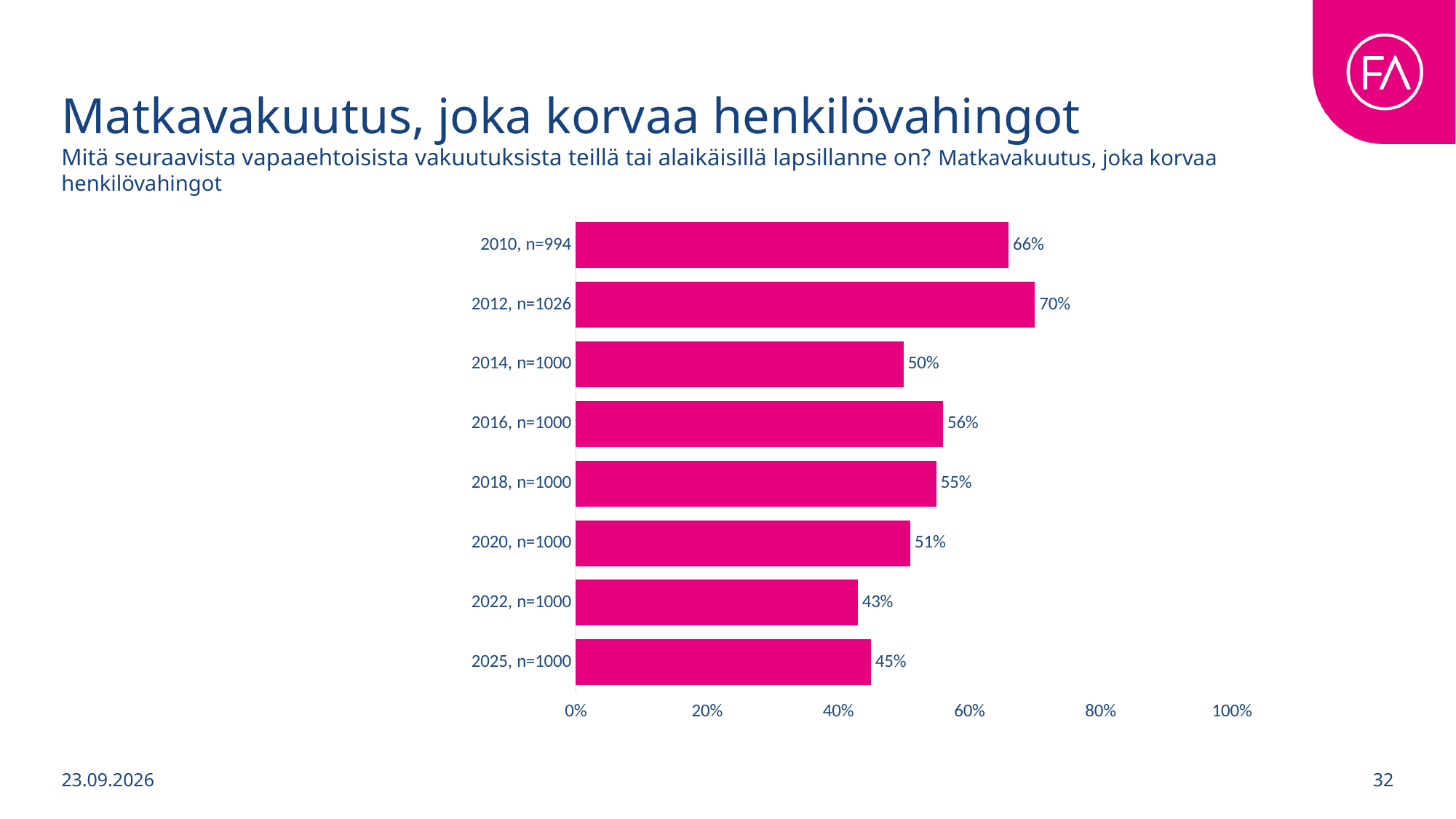
Which category has the highest value? 2012, n=1026 What is the value for 2018, n=1000? 55% Is the value for 2022, n=1000 greater or less than 60%? less Which is larger, the value for 2016, n=1000 or the value for 2020, n=1000? 2016, n=1000 What is the value for 2010, n=994? 66% What is the difference between the values for 2012, n=1026 and 2014, n=1000? 20% What is the difference between the values for 2025, n=1000 and 2022, n=1000? 2% What kind of chart is shown on the slide? bar chart Which category has the lowest value? 2022, n=1000 What is the value for 2025, n=1000? 45% What colour are the bars in the chart? pink How many categories are shown in the chart? 8